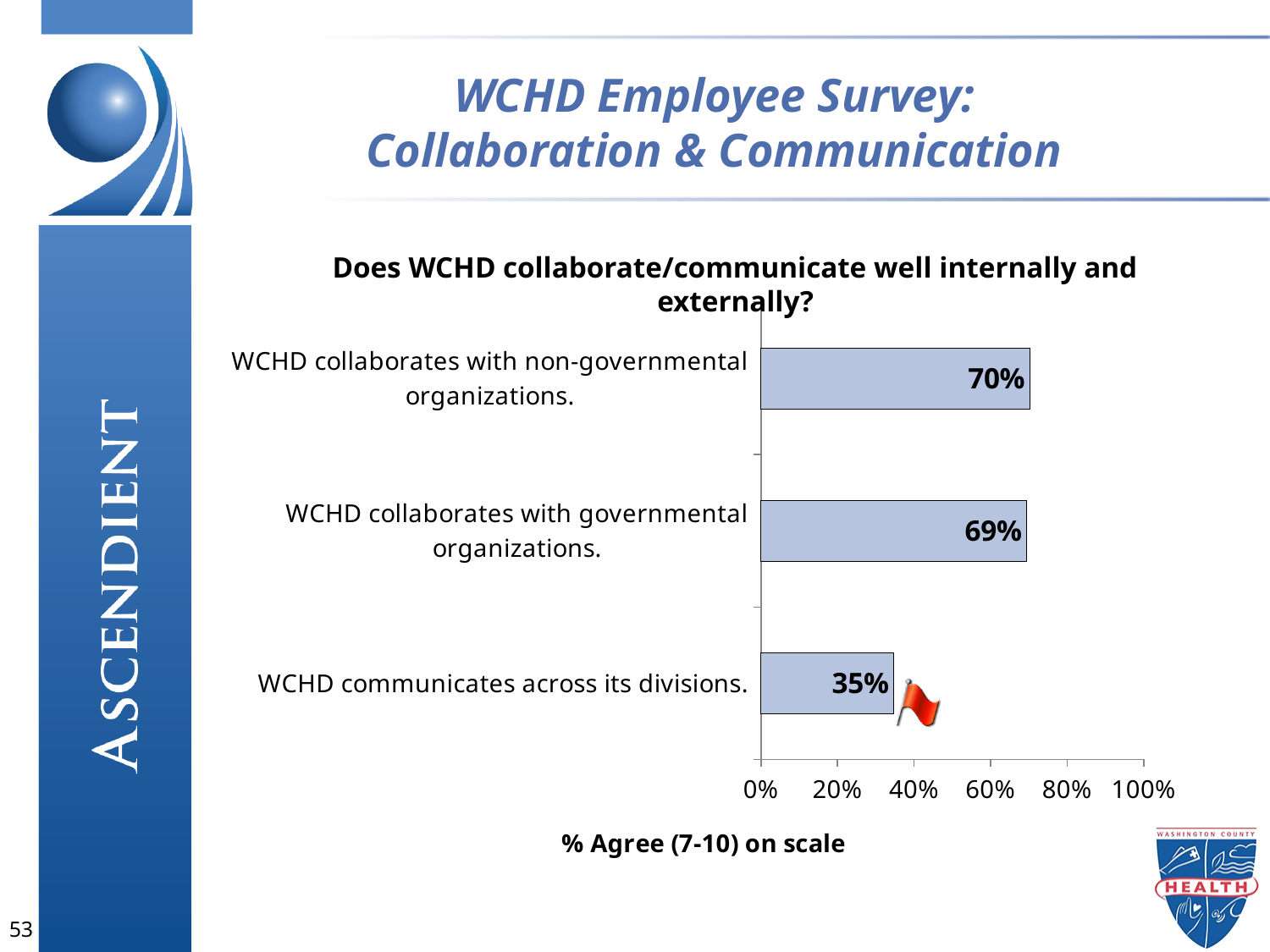
What percentage agree that WCHD collaborates with governmental organizations? 69% How many statements are shown in the chart? 3 Which has a higher agreement percentage: collaborating with governmental organizations or communicating across divisions? WCHD collaborates with governmental organizations. What kind of chart is shown on the slide? Bar chart What percentage agree that WCHD collaborates with non-governmental organizations? 70% What is the label on the horizontal axis of the chart? % Agree (7-10) on scale Which statement has the lowest percentage of agreement? WCHD communicates across its divisions. What is the difference in agreement between collaborating with governmental organizations and communicating across divisions? 34% Is the value for WCHD collaborates with non-governmental organizations greater or less than 60%? greater What is the difference in agreement between collaborating with non-governmental organizations and communicating across divisions? 35% Is the value for WCHD communicates across its divisions greater or less than 40%? less What percentage agree that WCHD communicates across its divisions? 35%